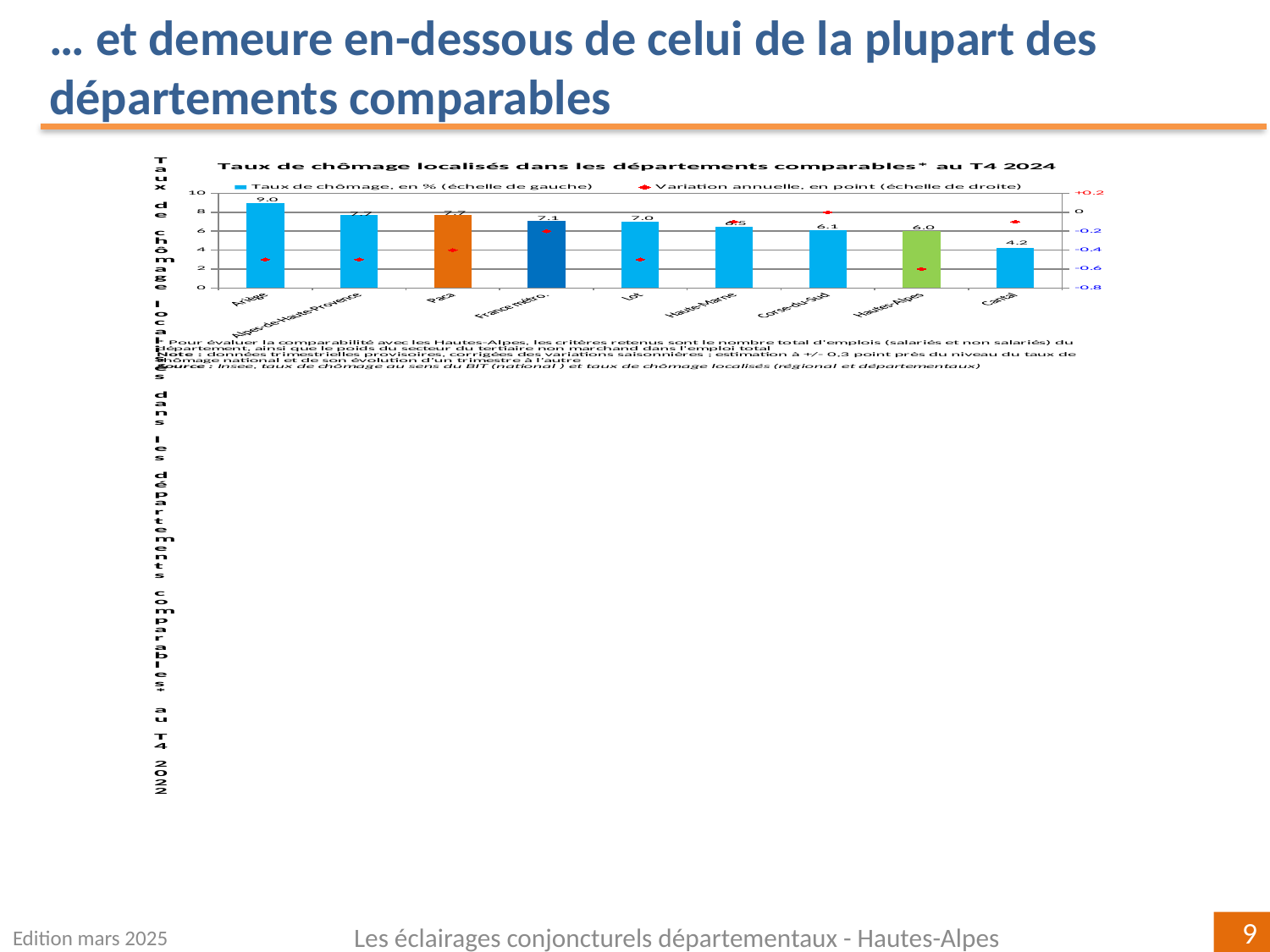
What is the difference between the unemployment rate of Ariège and that of Hautes-Alpes? 3.0 What kind of chart is used to show the unemployment rates? Bar chart Which has the higher unemployment rate, Lot or Hautes-Alpes? Lot How many series does the chart legend list? 2 Which department has the highest unemployment rate on the chart? Ariège Is the annual variation (red marker) for Hautes-Alpes greater or less than -0.4? less Which department has the lowest unemployment rate on the chart? Cantal Do the unemployment rate bars rise or fall from left to right along the x axis? Fall What is the unemployment rate shown for Ariège? 9.0 What is the unemployment rate shown for Hautes-Alpes? 6.0 How many departments or areas are shown on the x axis of the chart? 9 What is the unemployment rate shown for France métro.? 7.1